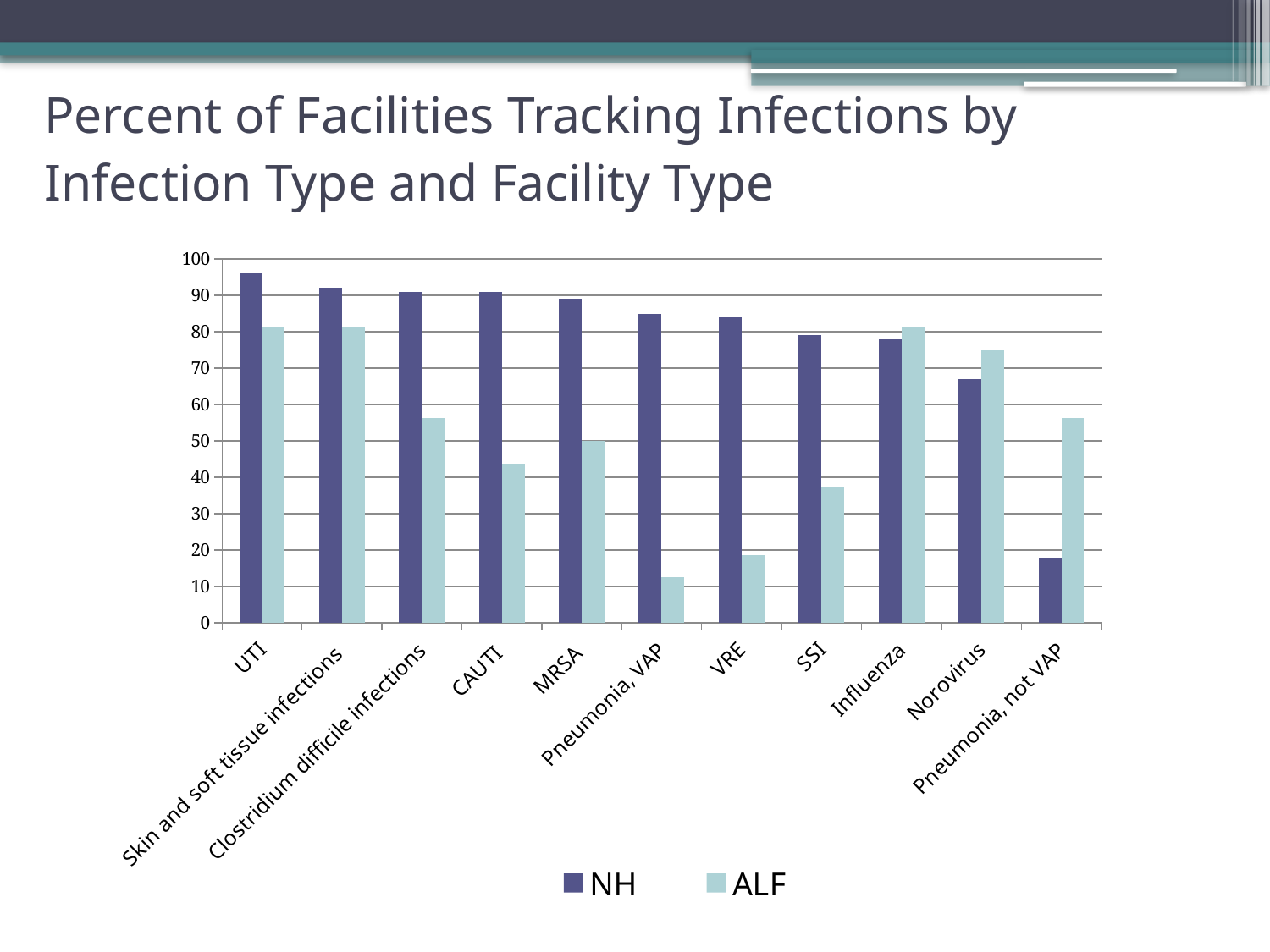
Which infection type has the highest NH value? UTI Is the ALF value for CAUTI greater or less than 50? less Is the NH value for UTI greater or less than 90? greater Is the ALF value for Pneumonia, VAP greater or less than 20? less How many infection types are shown on the x axis? 11 Do the NH values rise or fall moving left to right along the x axis? fall Which infection type has the lowest NH value? Pneumonia, not VAP What kind of chart is shown on the slide? bar chart How many series does the legend list? 2 For CAUTI, which series has the larger value, NH or ALF? NH For Norovirus, which series has the larger value, NH or ALF? ALF Which infection type has the lowest ALF value? Pneumonia, VAP